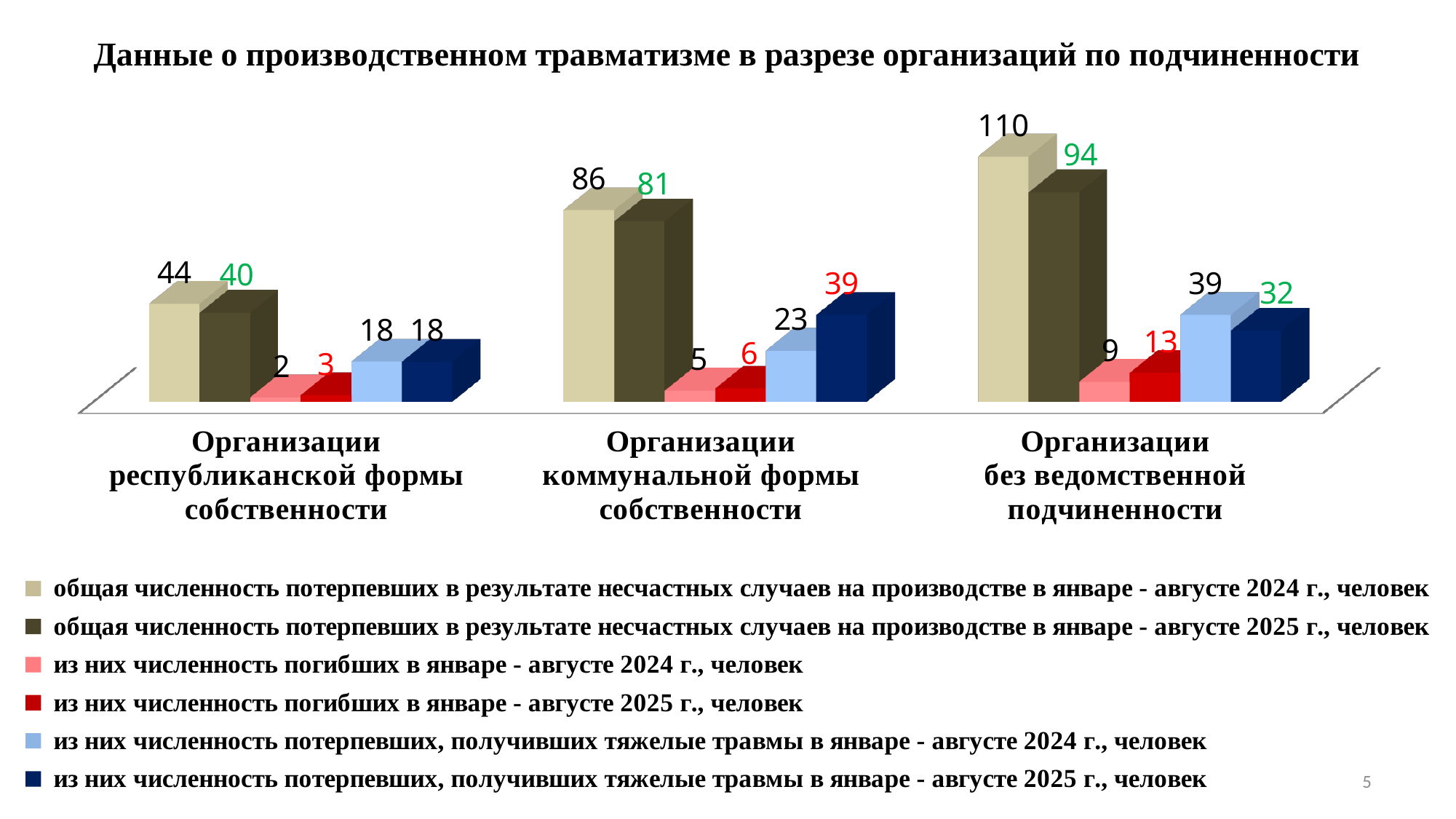
By how much did the total number of injured persons in 'Организации без ведомственной подчиненности' decrease from January–August 2024 to January–August 2025? 16 Which category has the highest total number of injured persons in January–August 2024? Организации без ведомственной подчиненности How many series does the legend list? 6 Which is larger for 'Организации коммунальной формы собственности': the number of severely injured in January–August 2024 or in January–August 2025? January–August 2025 (39) Which category has the lowest number of fatalities in January–August 2025? Организации республиканской формы собственности What type of chart is shown on the slide? Bar chart How many fatalities were recorded in January–August 2025 for 'Организации республиканской формы собственности'? 3 How many organisation categories are shown on the chart? 3 What is the total number of injured persons in January–August 2024 for 'Организации без ведомственной подчиненности'? 110 What is the total number of injured persons in January–August 2025 for 'Организации коммунальной формы собственности'? 81 What colour represents the number of fatalities in January–August 2025 in the legend? Red How many persons received severe injuries in January–August 2025 in 'Организации коммунальной формы собственности'? 39